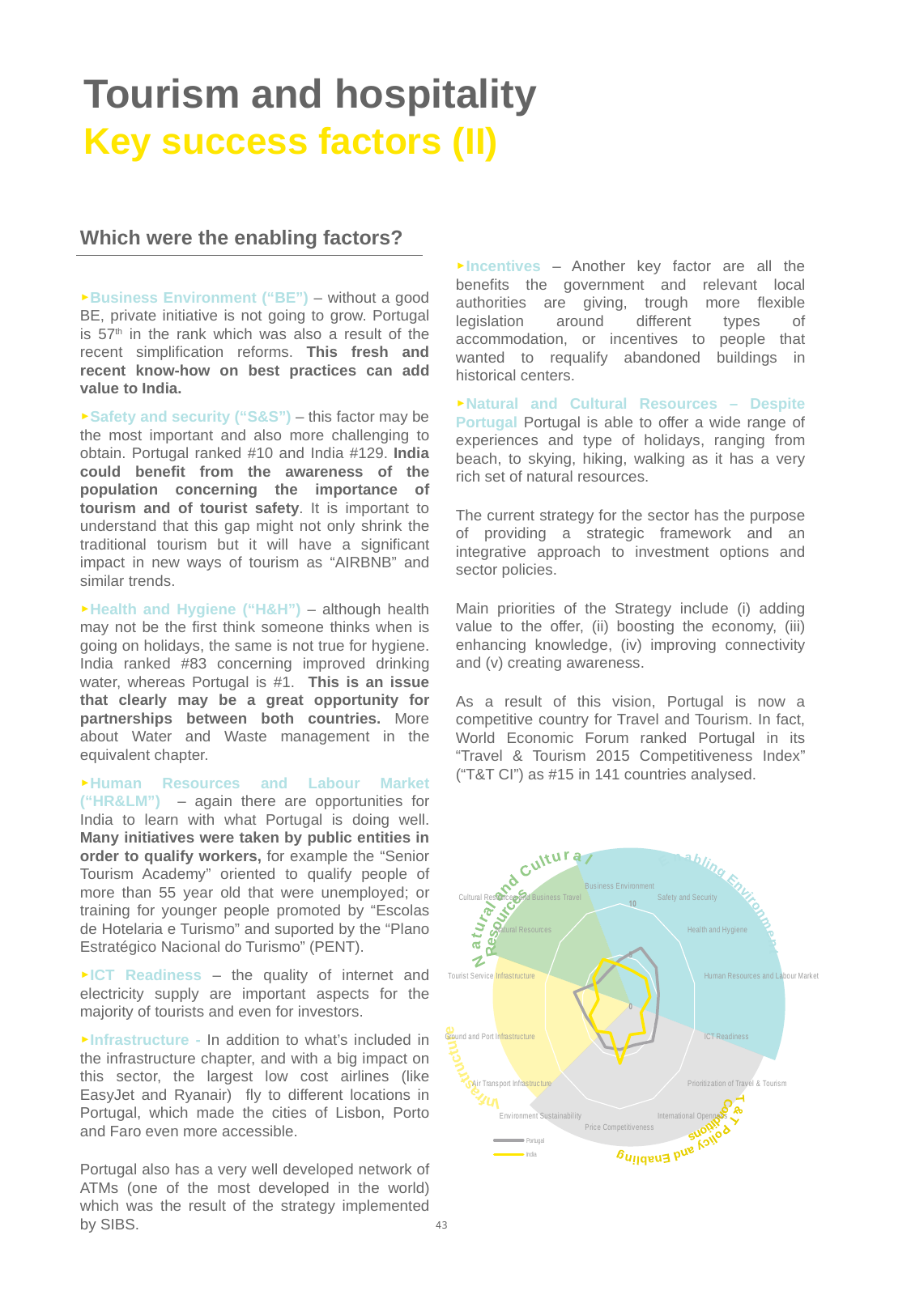
Which colour represents India in the chart? yellow What kind of chart is shown on the slide? radar chart How many categories (axes) does the radar chart have? 14 Which two countries are listed in the chart's legend? Portugal and India How many series does the chart's legend list? 2 Which series, Portugal or India, generally extends further from the centre of the radar chart? Portugal